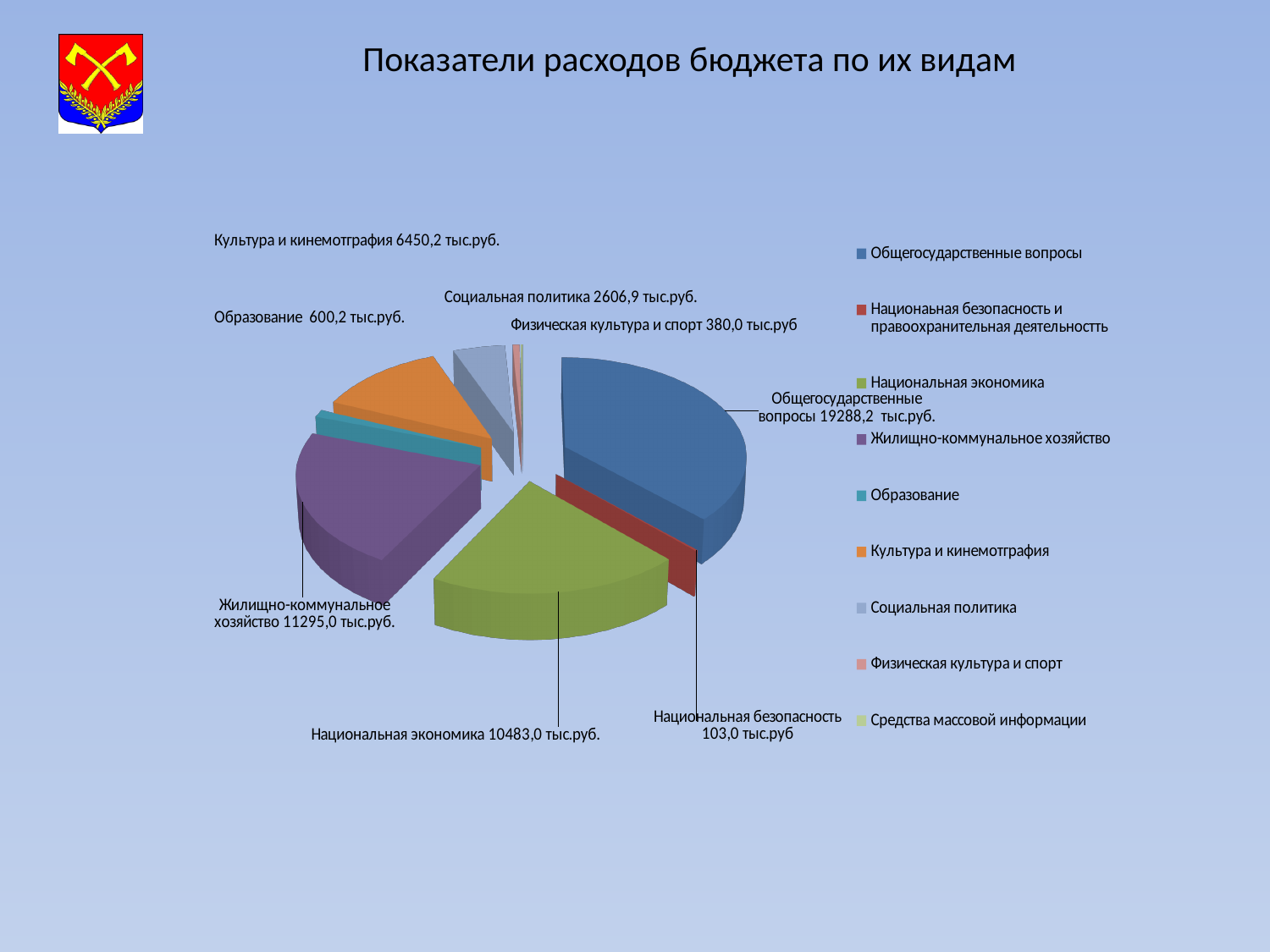
How many entries does the legend list? 9 What is the value for Жилищно-коммунальное хозяйство? 11295,0 тыс.руб. What is the value for Национальная безопасность? 103,0 тыс.руб What is the value for Социальная политика? 2606,9 тыс.руб. What kind of chart is shown on the slide? Pie chart What is the value for Национальная экономика? 10483,0 тыс.руб. What is the difference between Жилищно-коммунальное хозяйство and Национальная экономика? 812,0 тыс.руб. Which is larger, Культура и кинемотграфия or Социальная политика? Культура и кинемотграфия What is the title of the slide? Показатели расходов бюджета по их видам Which category has the largest value? Общегосударственные вопросы Which labelled category has the smallest value? Национальная безопасность What is the value for Общегосударственные вопросы? 19288,2 тыс.руб.